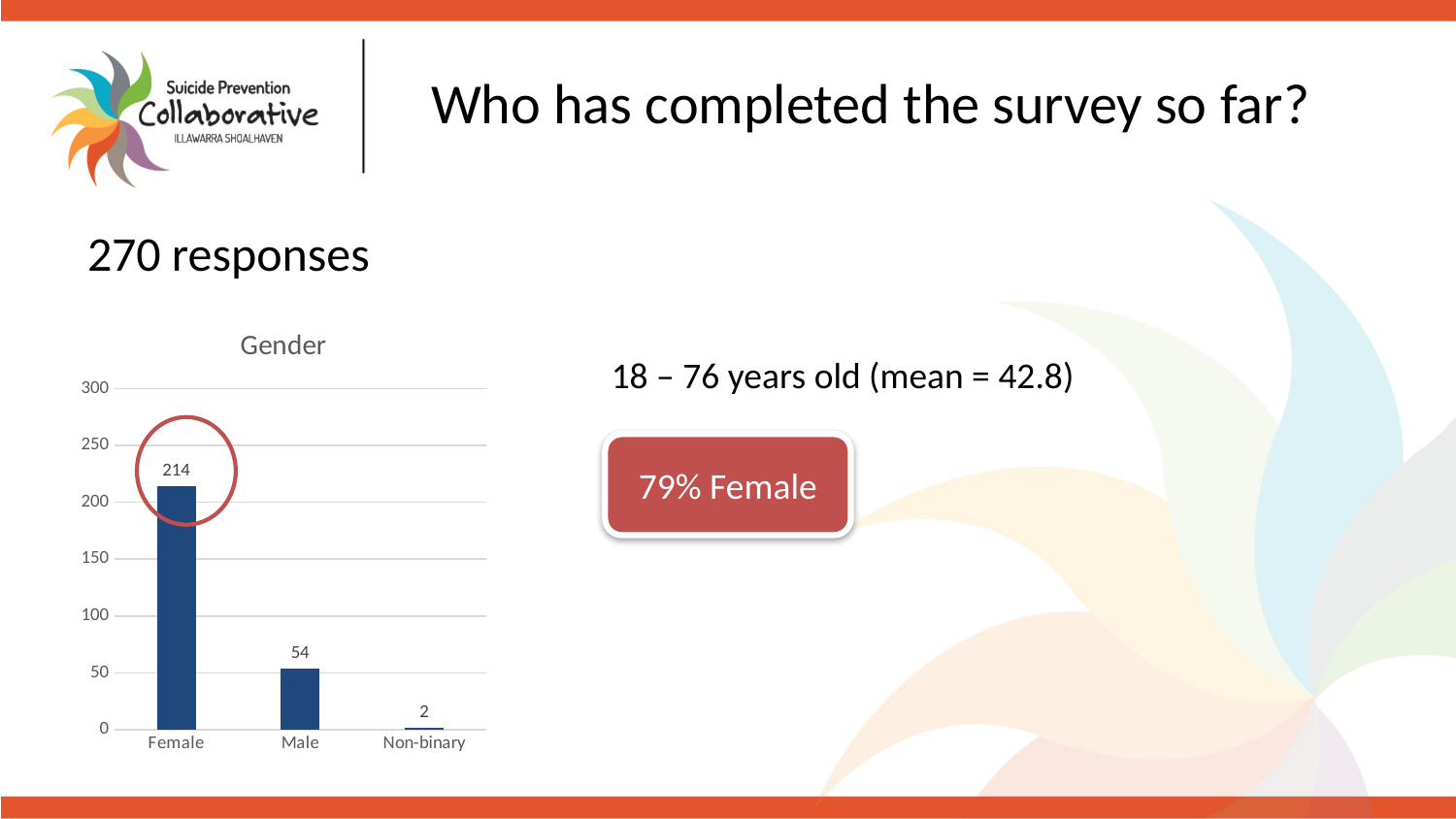
Do the values rise or fall from left to right across the Gender chart? fall What is the value for Female in the Gender chart? 214 Which category has the highest value in the Gender chart? Female What is the value for Male in the Gender chart? 54 Which category has the lowest value in the Gender chart? Non-binary Is the value for Female greater or less than 200 in the Gender chart? greater What is the difference between the Female and Male values in the Gender chart? 160 What is the title of the chart on the slide? Gender What is the value for Non-binary in the Gender chart? 2 What kind of chart is the Gender chart? bar chart Which is larger in the Gender chart, Male or Non-binary? Male How many categories are shown in the Gender chart? 3